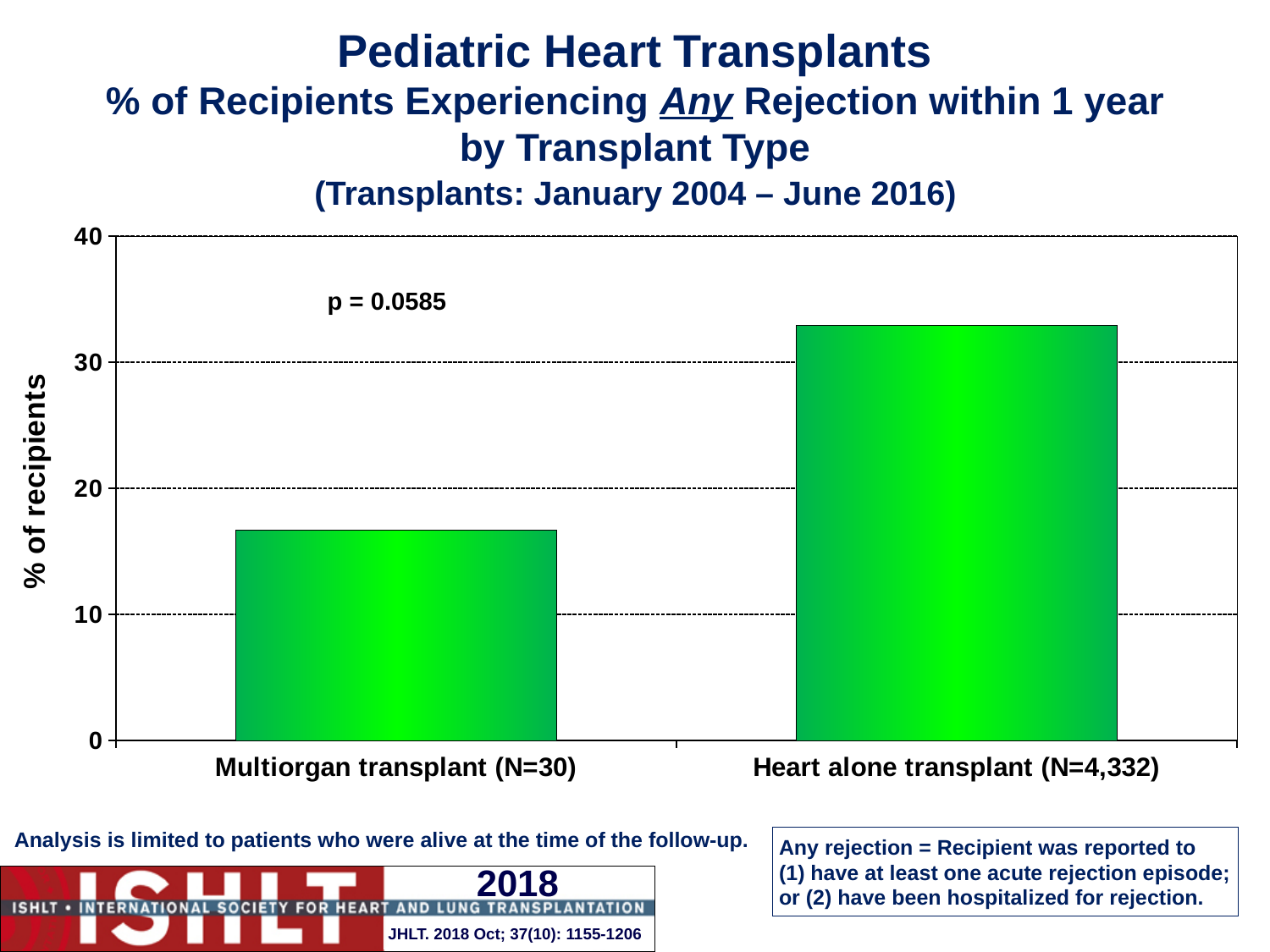
Is the bar for Heart alone transplant taller or shorter than the bar for Multiorgan transplant? taller What kind of chart is shown on the slide? bar chart Is the value for Multiorgan transplant (N=30) greater or less than 20? less What p-value is printed on the chart? p = 0.0585 Which transplant type has the higher % of recipients experiencing any rejection within 1 year? Heart alone transplant (N=4,332) What is the maximum value shown on the y-axis? 40 Is the value for Heart alone transplant (N=4,332) greater or less than 40? less Is the value for Multiorgan transplant (N=30) greater or less than 10? greater What is the label of the y-axis? % of recipients How many transplant type categories are plotted in the chart? 2 Which transplant type has the lower % of recipients experiencing any rejection within 1 year? Multiorgan transplant (N=30)